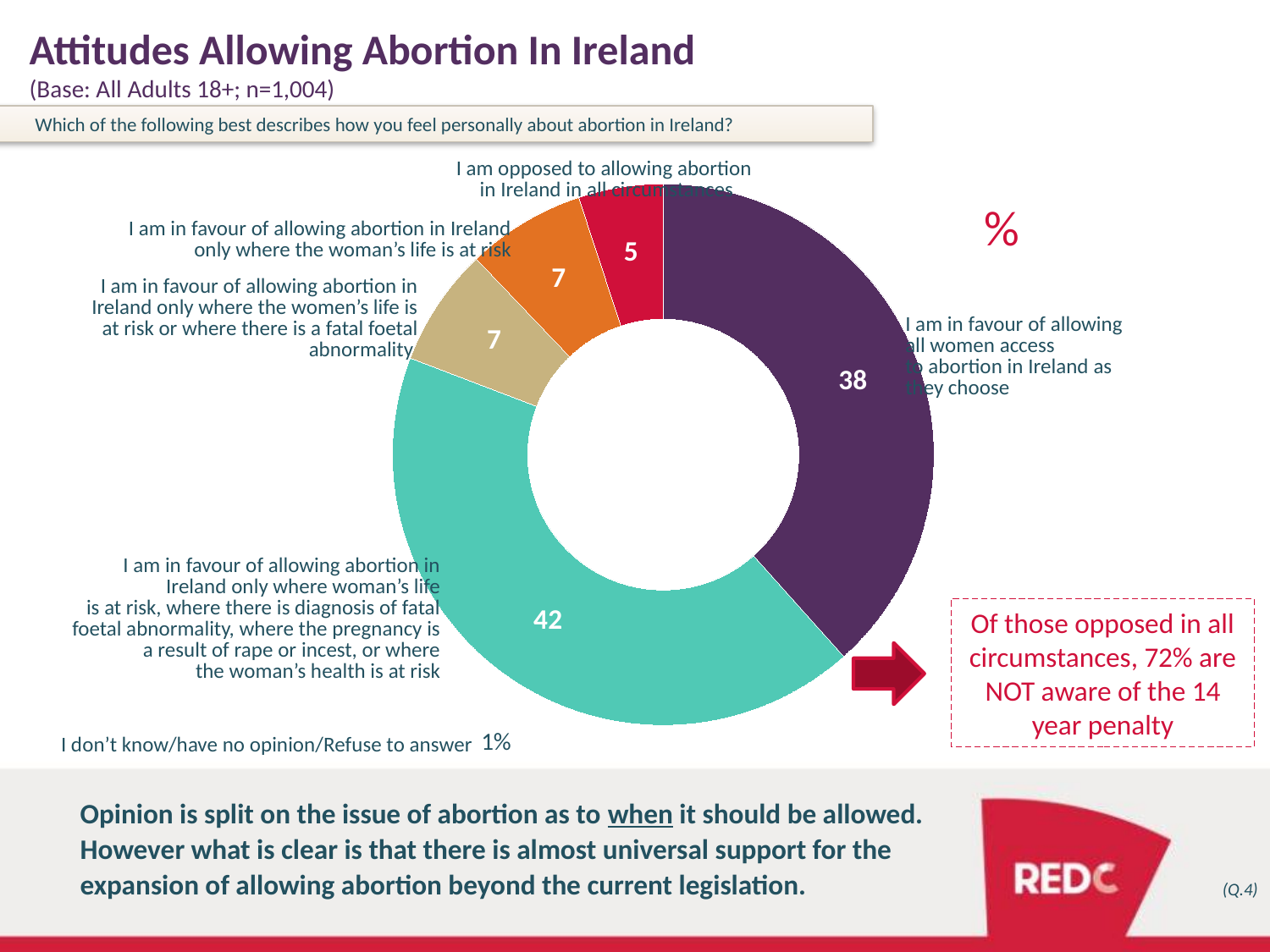
What is the combined value of the two segments labelled 7? 14 What value is shown for the segment 'I am in favour of allowing abortion in Ireland only where the woman's life is at risk'? 7 What value is shown for the segment 'I am opposed to allowing abortion in Ireland in all circumstances'? 5 What percentage is given for 'I don't know/have no opinion/Refuse to answer'? 1% Which plotted response has the smallest segment in the chart? I am opposed to allowing abortion in Ireland in all circumstances Which is larger: the value for 'I am in favour of allowing all women access to abortion in Ireland as they choose' or the value for 'I am opposed to allowing abortion in Ireland in all circumstances'? I am in favour of allowing all women access to abortion in Ireland as they choose What is the difference between the value for the largest segment (42) and the value for 'I am in favour of allowing all women access to abortion in Ireland as they choose'? 4 What value is shown for the segment 'I am in favour of allowing all women access to abortion in Ireland as they choose'? 38 What is the title of the chart on this slide? Attitudes Allowing Abortion In Ireland What type of chart is used on this slide? Pie (donut) chart What value is shown for the largest segment, covering cases where the woman's life is at risk, fatal foetal abnormality, rape or incest, or the woman's health is at risk? 42